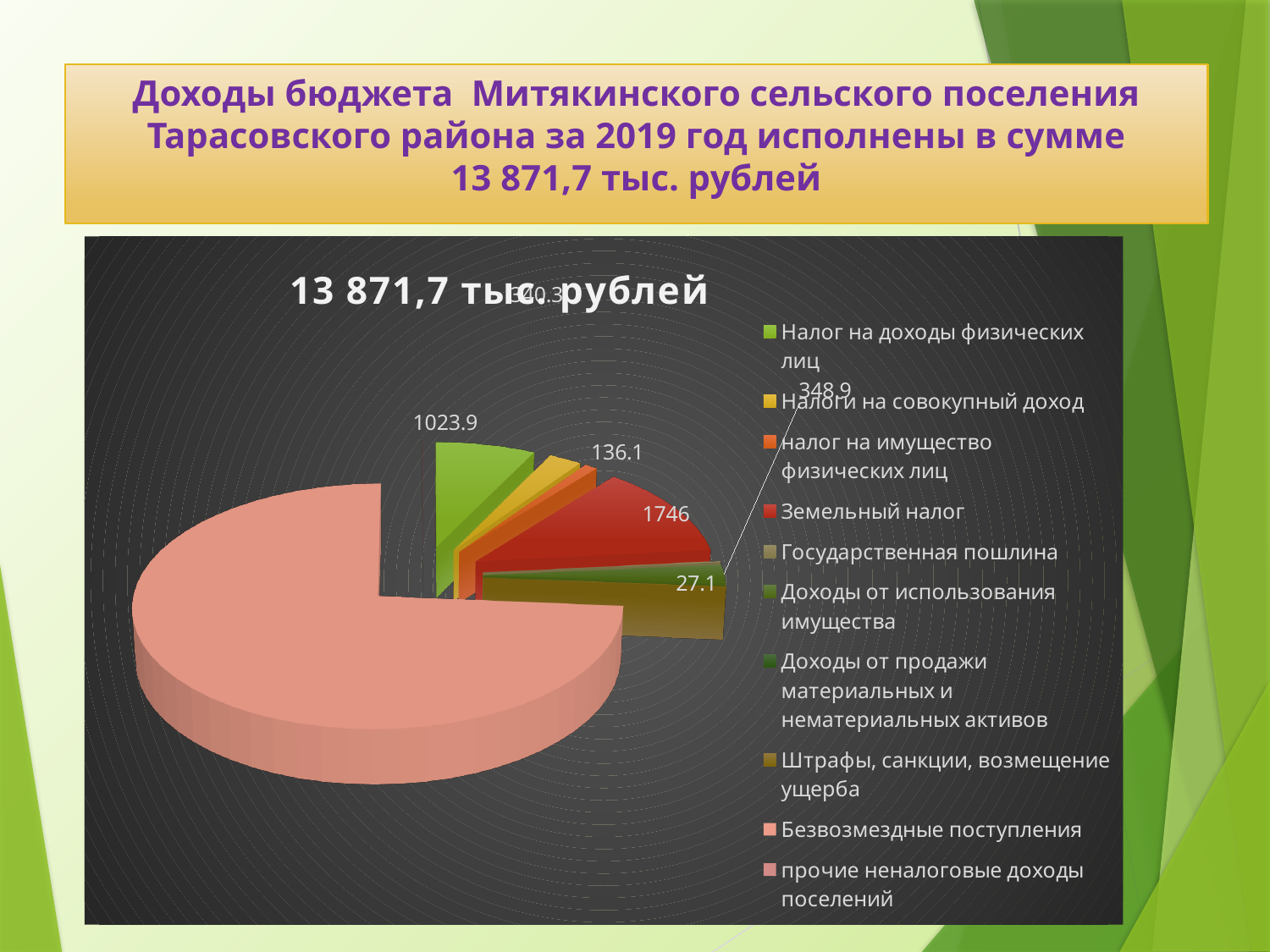
Which category has the largest slice of the pie? Безвозмездные поступления What kind of chart is shown on the slide? pie chart What is the difference between the values for Земельный налог and Налог на доходы физических лиц? 722.1 What is the title of the chart? 13 871,7 тыс. рублей What is the value shown for Земельный налог? 1746 How many categories does the chart legend list? 10 What is the value shown for Налог на доходы физических лиц? 1023.9 What colour is the slice for Земельный налог? red Which is larger, Земельный налог or Налог на доходы физических лиц? Земельный налог Is the value for Земельный налог greater or less than 1000? greater